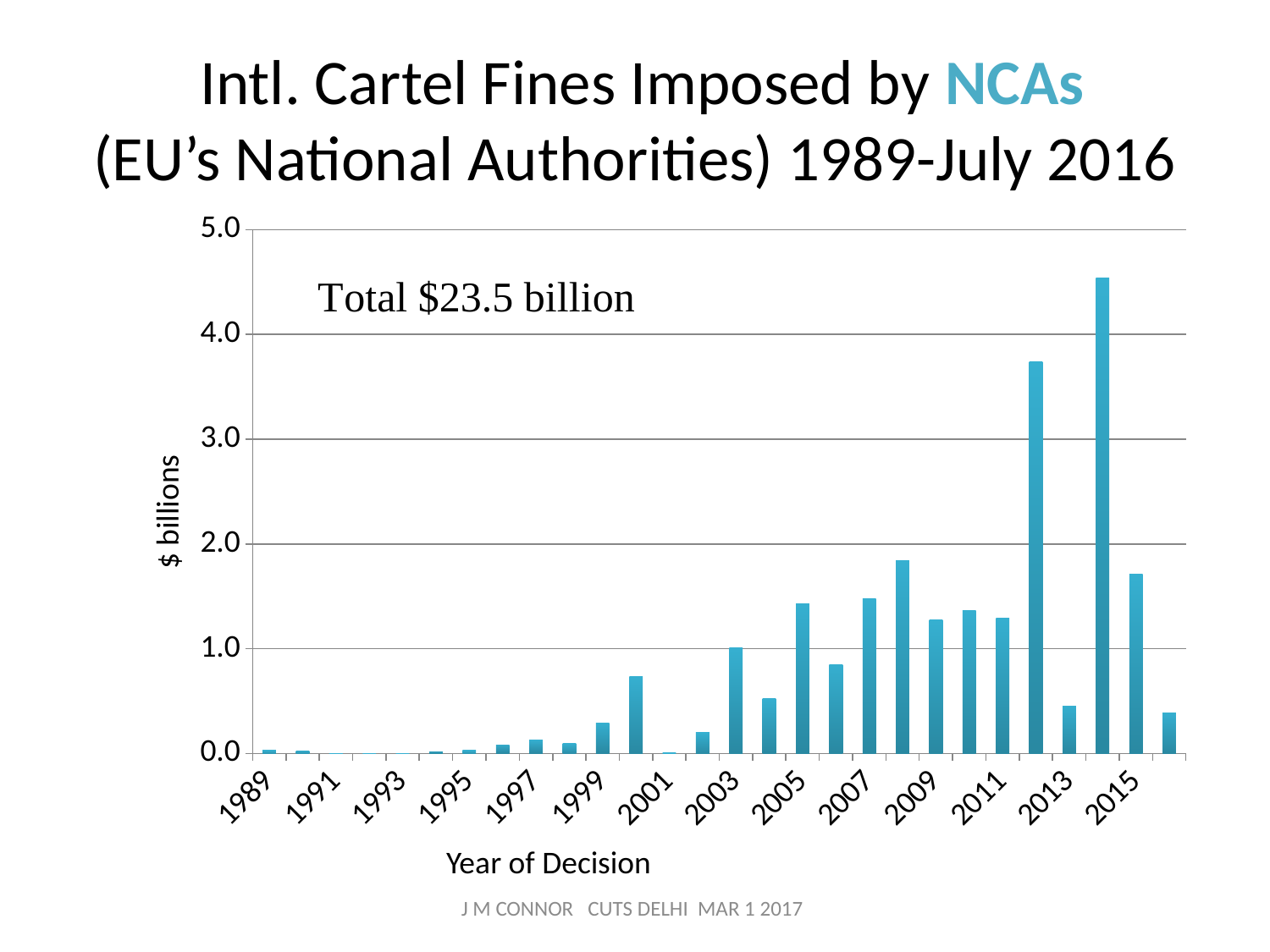
Is the value for 2012 greater or less than 3.0? greater Is the value for 2016 greater or less than 1.0? less Which year has the larger value, 2005 or 2006? 2005 Which year has the larger value, 2012 or 2014? 2014 What kind of chart is shown on the slide? bar chart Is the value for 2012 greater or less than 4.0? less Do the fines generally rise or fall from 1989 to 2014? rise What is the label of the vertical axis? $ billions Which year has the highest fines in the chart? 2014 What total amount is stated in the annotation on the chart? Total $23.5 billion